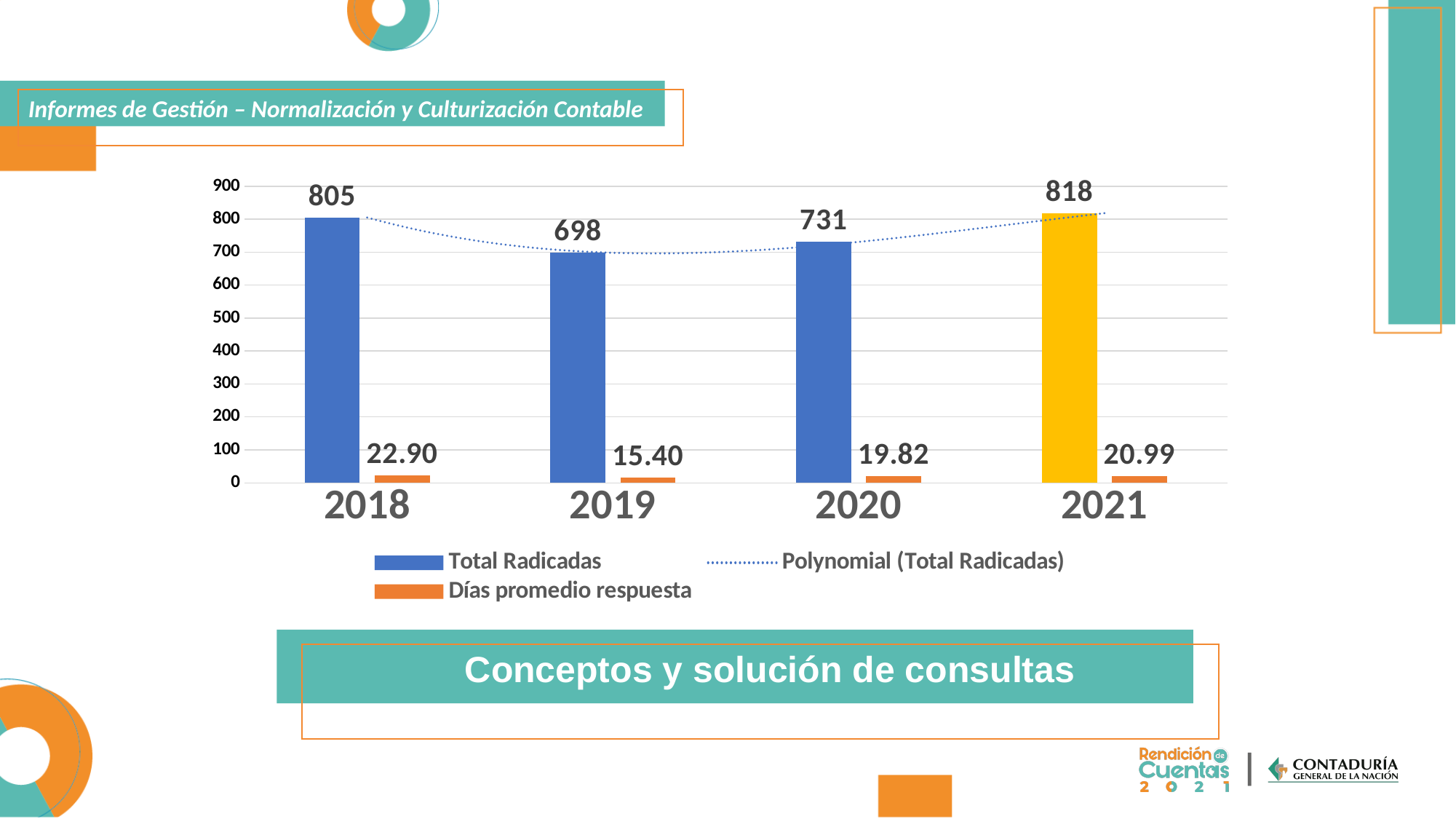
What is the difference in Total Radicadas between 2018 and 2019? 107 What is the Total Radicadas value for 2018? 805 How many years are shown on the x axis? 4 How many entries does the legend list? 3 Which year has the larger Total Radicadas, 2019 or 2020? 2020 What is the Días promedio respuesta value for 2020? 19.82 Is the Total Radicadas value for 2020 greater or less than 800? less Which year has the lowest Días promedio respuesta? 2019 What is the label of the dotted trend line in the legend? Polynomial (Total Radicadas) What kind of chart is shown on the slide? bar chart Which year has the highest Total Radicadas? 2021 What is the Total Radicadas value for 2021? 818